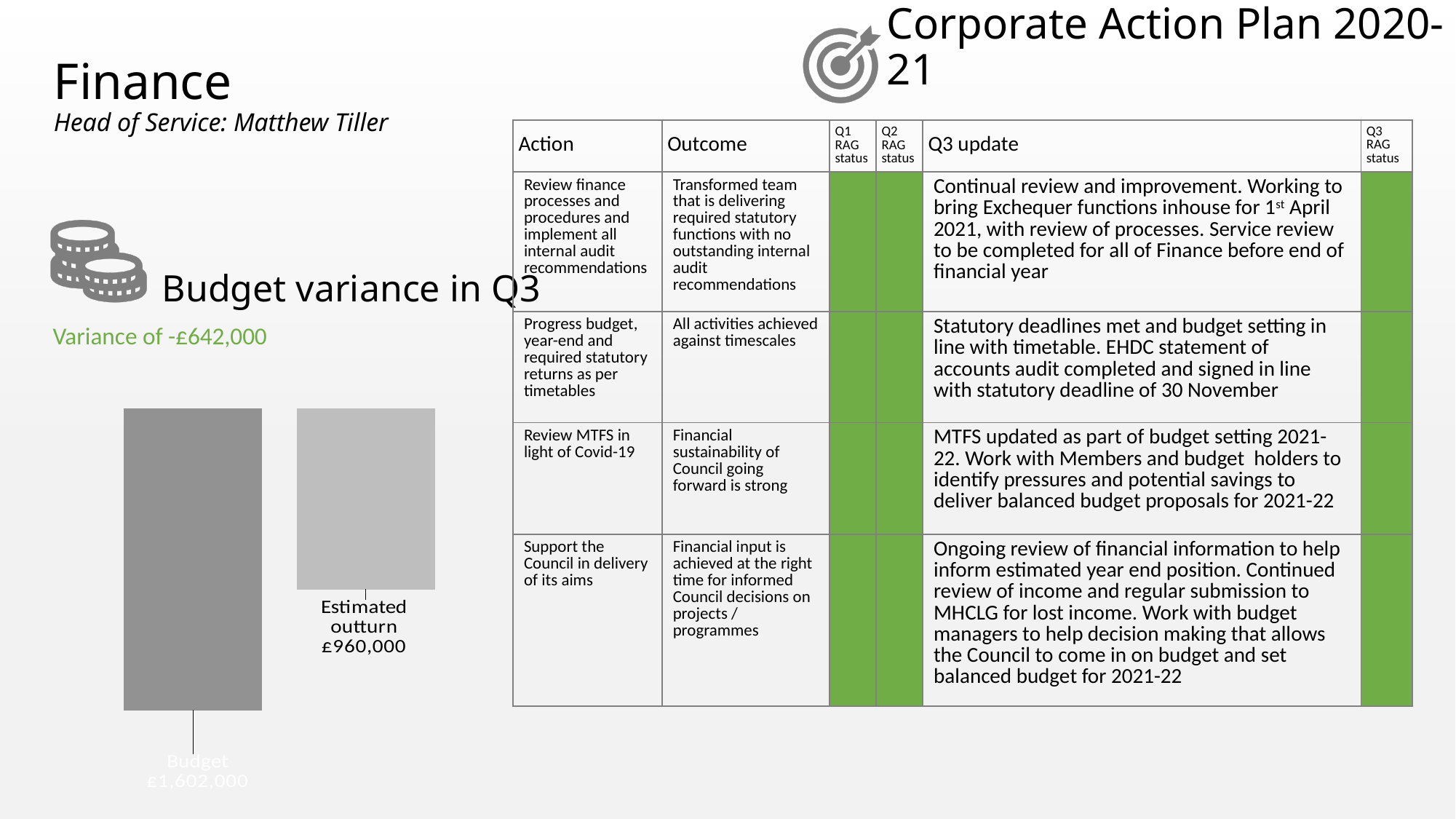
Which bar is taller in the Budget variance in Q3 chart, Budget or Estimated outturn? Budget What is the value of the Estimated outturn bar in the Budget variance in Q3 chart? £960,000 What is the title of the chart on the left of the slide? Budget variance in Q3 What is the value of the Budget bar in the Budget variance in Q3 chart? £1,602,000 How many bars are shown in the Budget variance in Q3 chart? 2 What type of chart is used to show Budget variance in Q3? Bar chart What is the difference between the Budget and Estimated outturn values in the Budget variance in Q3 chart? £642,000